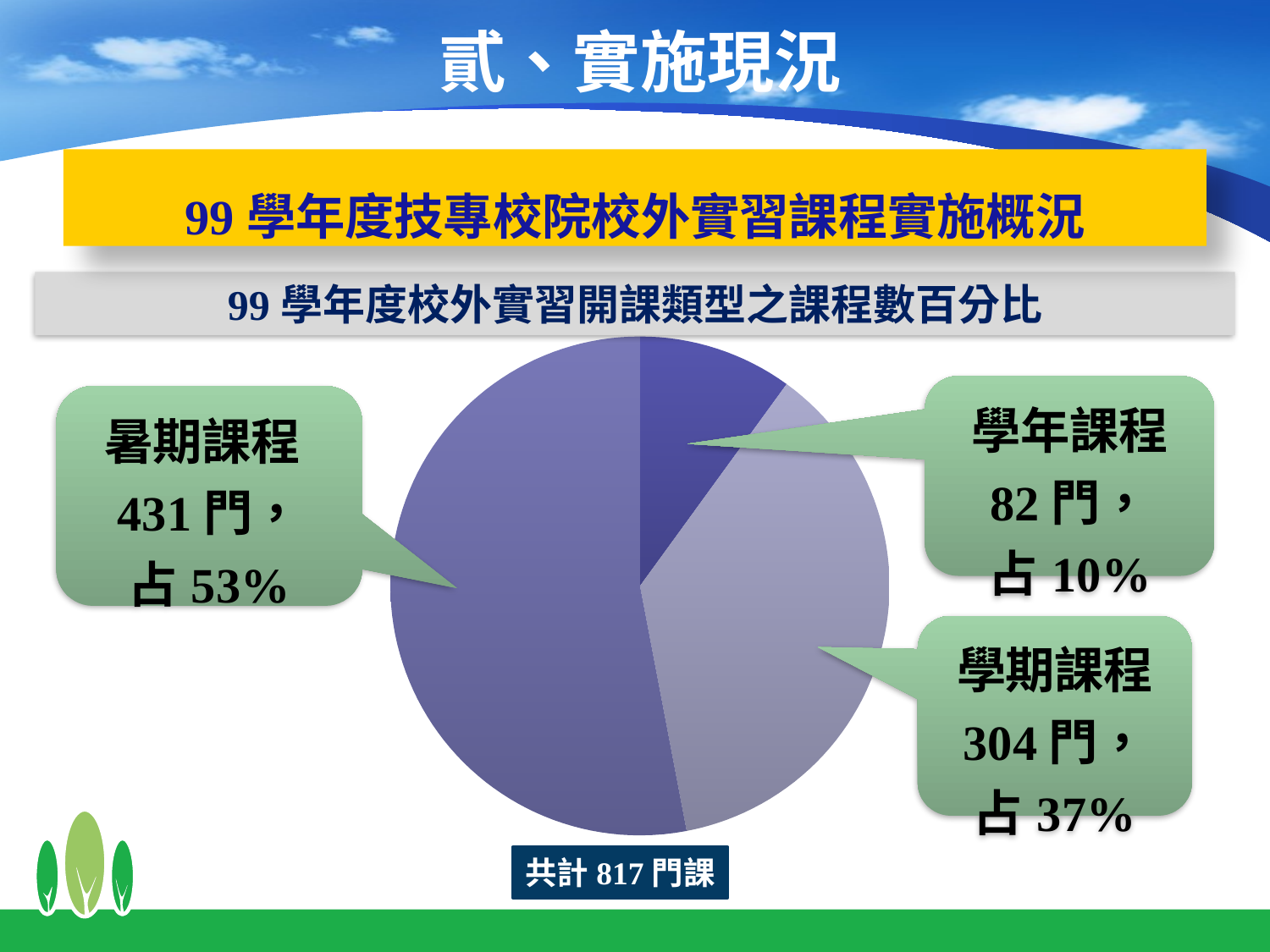
What is the difference in number of courses between 暑期課程 and 學期課程? 127 門 What is the total number of courses shown for the pie chart? 817 門課 What percentage of courses does 學年課程 account for? 10% What is the title of the pie chart? 99 學年度校外實習開課類型之課程數百分比 What kind of chart is shown on the slide? pie chart What percentage of courses does 暑期課程 account for? 53% Which course type has the smallest share of the pie? 學年課程 How many courses (門) does the 暑期課程 slice represent? 431 門 How many slices does the pie chart have? 3 How many courses (門) does the 學期課程 slice represent? 304 門 Which course type has the largest share of the pie? 暑期課程 Which has more courses, 學期課程 or 學年課程? 學期課程